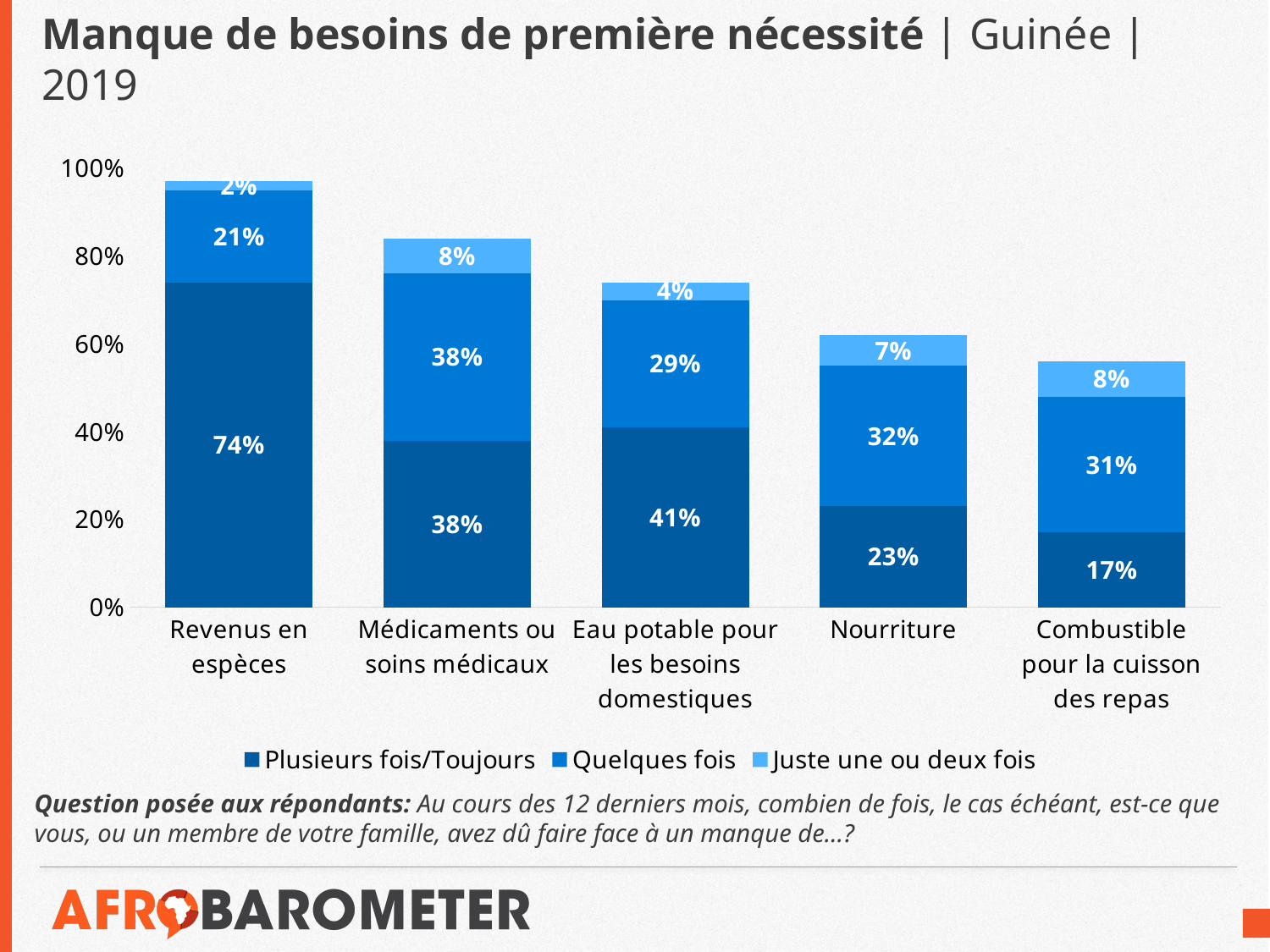
What is the total of the stacked bar for Nourriture? 62% What kind of chart is shown on the slide? Stacked bar chart How many series does the legend list? 3 How many categories are shown on the x axis? 5 What is the total of the stacked bar for Revenus en espèces? 97% What percentage of respondents said they went without cash income (Revenus en espèces) 'Plusieurs fois/Toujours'? 74% What is the 'Quelques fois' value for Nourriture? 32% Which category has the highest 'Plusieurs fois/Toujours' value? Revenus en espèces Which category has the lowest 'Plusieurs fois/Toujours' value? Combustible pour la cuisson des repas Which is larger: the 'Quelques fois' value for Médicaments ou soins médicaux or for Eau potable pour les besoins domestiques? Médicaments ou soins médicaux What is the difference between the 'Plusieurs fois/Toujours' values for Eau potable pour les besoins domestiques and Nourriture? 18 percentage points What is the 'Juste une ou deux fois' value for Combustible pour la cuisson des repas? 8%